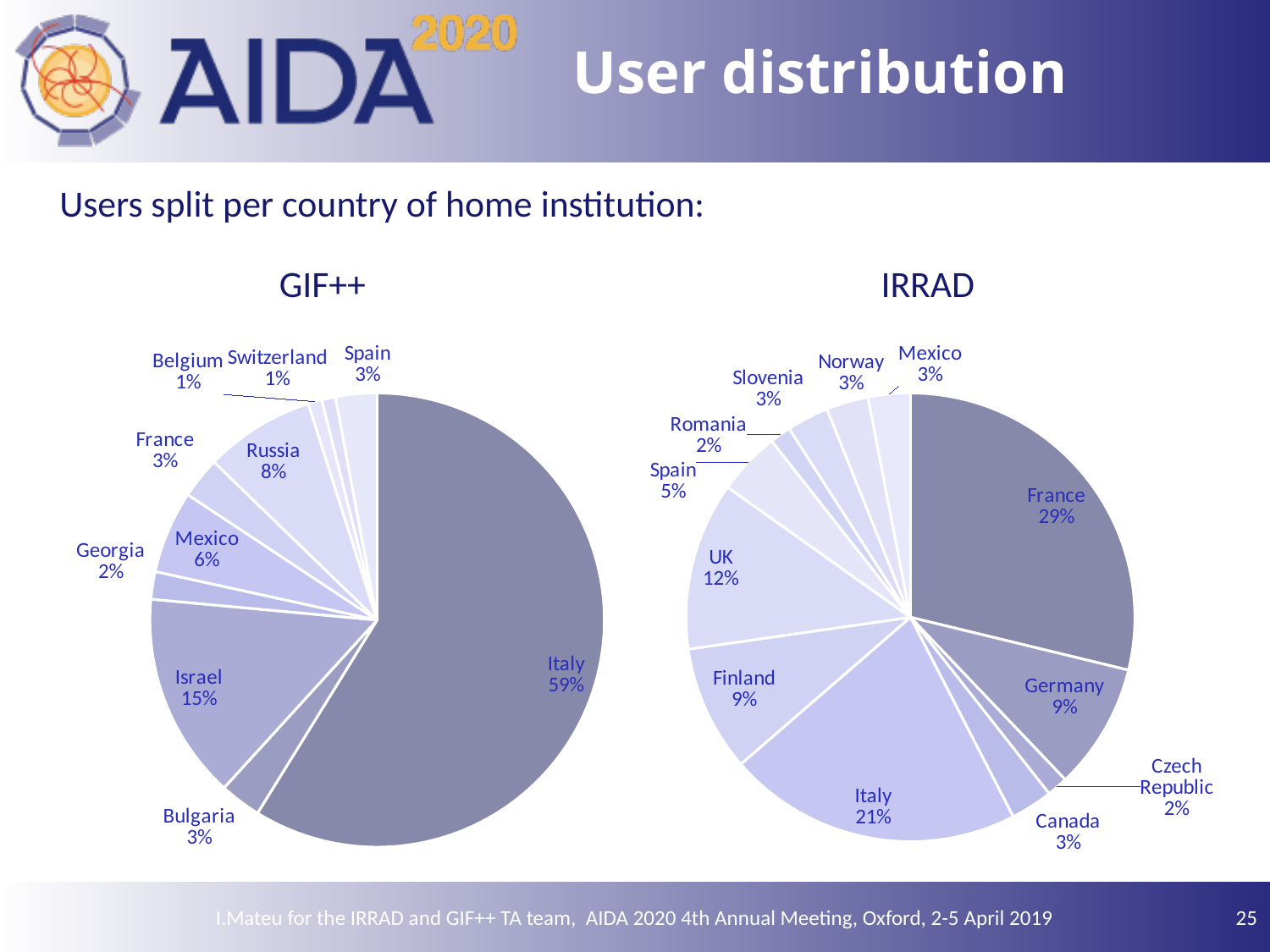
In the IRRAD chart, which country has the largest share of users? France In the IRRAD chart, which has the larger share, Germany or Spain? Germany In the GIF++ chart, which country has the largest share of users? Italy In the GIF++ chart, what is the difference in percentage points between Italy and Israel? 44 In the IRRAD chart, what share of users comes from the UK? 12% What type of chart is used for the GIF++ user distribution? Pie chart How many countries are shown in the IRRAD pie chart? 12 In the GIF++ chart, what share of users comes from Italy? 59% In the IRRAD chart, what share of users comes from France? 29% In the IRRAD chart, what is the difference in percentage points between France and Italy? 8 In the GIF++ chart, what share of users comes from Israel? 15% How many countries are shown in the GIF++ pie chart? 10